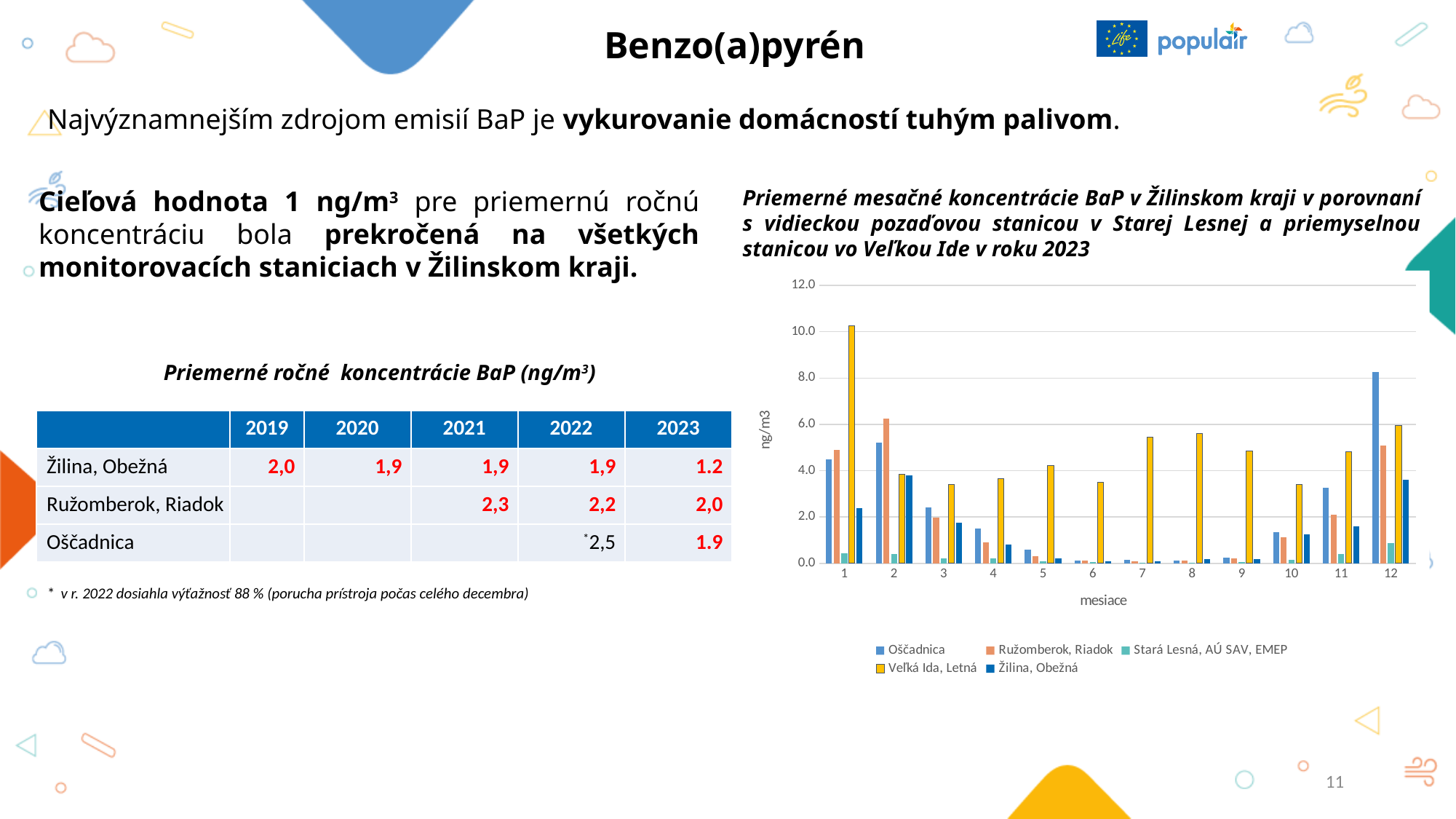
In the monthly BaP chart, which series has the lowest bar in month 1? Stará Lesná, AÚ SAV, EMEP What kind of chart is shown on the right side of the slide? bar chart How many series does the legend of the monthly BaP chart list? 5 In the monthly BaP chart, which is larger in month 12: Oščadnica or Veľká Ida, Letná? Oščadnica In the monthly BaP chart, is the value for Oščadnica in month 12 greater or less than 6.0? greater In the monthly BaP chart, in which month is the Veľká Ida, Letná bar the highest? 1 What is the label of the y axis of the monthly BaP chart? ng/m3 In the monthly BaP chart, which series has the highest bar in month 12? Oščadnica In the monthly BaP chart, which is larger in month 2: Ružomberok, Riadok or Oščadnica? Ružomberok, Riadok How many months are shown on the x axis of the monthly BaP chart? 12 In the monthly BaP chart, is the value for Žilina, Obežná in month 1 greater or less than 4.0? less In the monthly BaP chart, is the value for Veľká Ida, Letná in month 1 greater or less than 10.0? greater